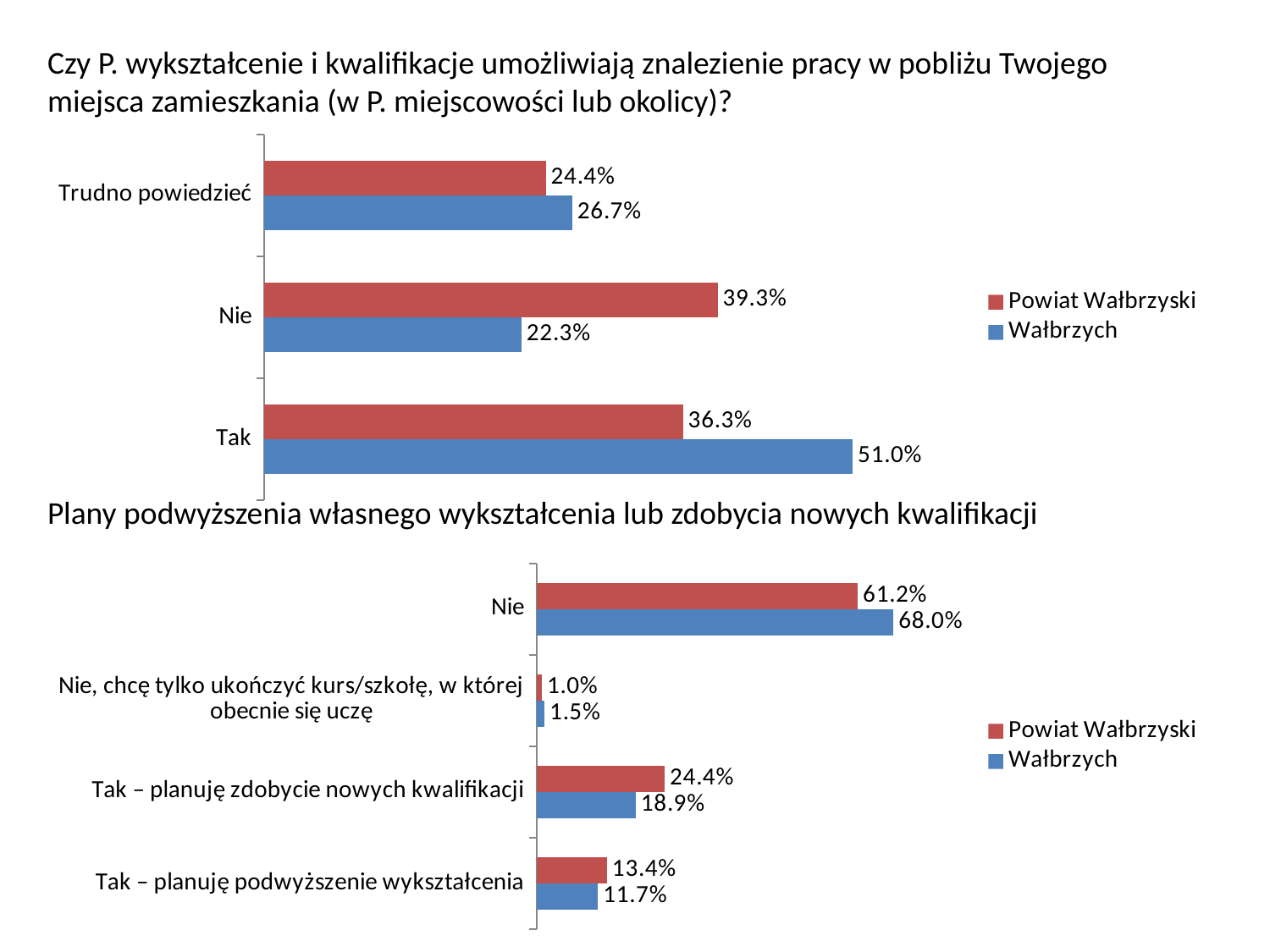
In the bottom chart, what is the difference between the Wałbrzych and Powiat Wałbrzyski values for "Nie"? 6.8% In the bottom chart, how many categories are shown? 4 What kind of chart is the bottom chart ("Plany podwyższenia własnego wykształcenia lub zdobycia nowych kwalifikacji")? Bar chart In the top chart, for "Nie", which is larger: Powiat Wałbrzyski or Wałbrzych? Powiat Wałbrzyski In the top chart, what is the difference between the Wałbrzych and Powiat Wałbrzyski values for "Tak"? 14.7% In the top chart, what is the value for Powiat Wałbrzyski for "Nie"? 39.3% In the bottom chart, which category has the lowest value for Powiat Wałbrzyski? Nie, chcę tylko ukończyć kurs/szkołę, w której obecnie się uczę In the top chart, how many series does the legend list? 2 In the bottom chart, what is the value for Wałbrzych for "Nie"? 68.0% In the bottom chart, what is the value for Powiat Wałbrzyski for "Tak – planuję zdobycie nowych kwalifikacji"? 24.4% In the top chart (about whether education and qualifications enable finding work nearby), what is the value for Wałbrzych for "Tak"? 51.0% In the top chart, which category has the highest value for Wałbrzych? Tak